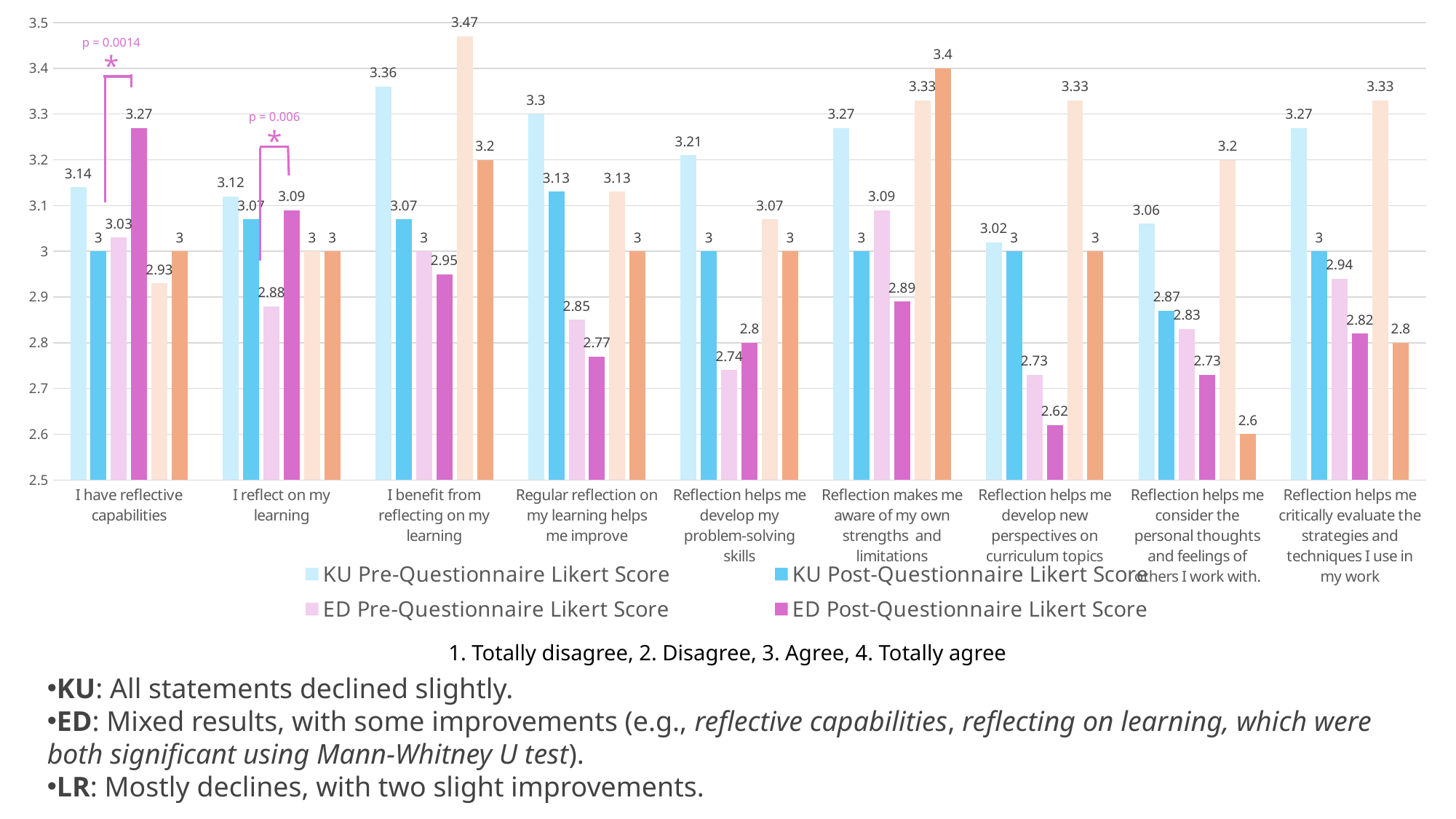
What is the KU Post-Questionnaire Likert Score for "Reflection helps me consider the personal thoughts and feelings of others I work with"? 2.87 Is the ED Pre-Questionnaire Likert Score for "Reflection helps me develop my problem-solving skills" greater or less than 2.8? less For "Regular reflection on my learning helps me improve", which is larger: the KU Post-Questionnaire Likert Score or the ED Pre-Questionnaire Likert Score? KU Post-Questionnaire Likert Score What is the difference between the ED Post-Questionnaire and ED Pre-Questionnaire Likert Scores for "I have reflective capabilities"? 0.24 How many statement categories are shown on the x axis? 9 Which category has the lowest ED Post-Questionnaire Likert Score? Reflection helps me develop new perspectives on curriculum topics What kind of chart is shown on the slide? Bar chart What is the KU Pre-Questionnaire Likert Score for "I have reflective capabilities"? 3.14 What is the ED Pre-Questionnaire Likert Score for "Reflection helps me develop new perspectives on curriculum topics"? 2.73 Which category has the highest KU Pre-Questionnaire Likert Score? I benefit from reflecting on my learning How many series does the legend list? 4 What is the ED Post-Questionnaire Likert Score for "I reflect on my learning"? 3.09